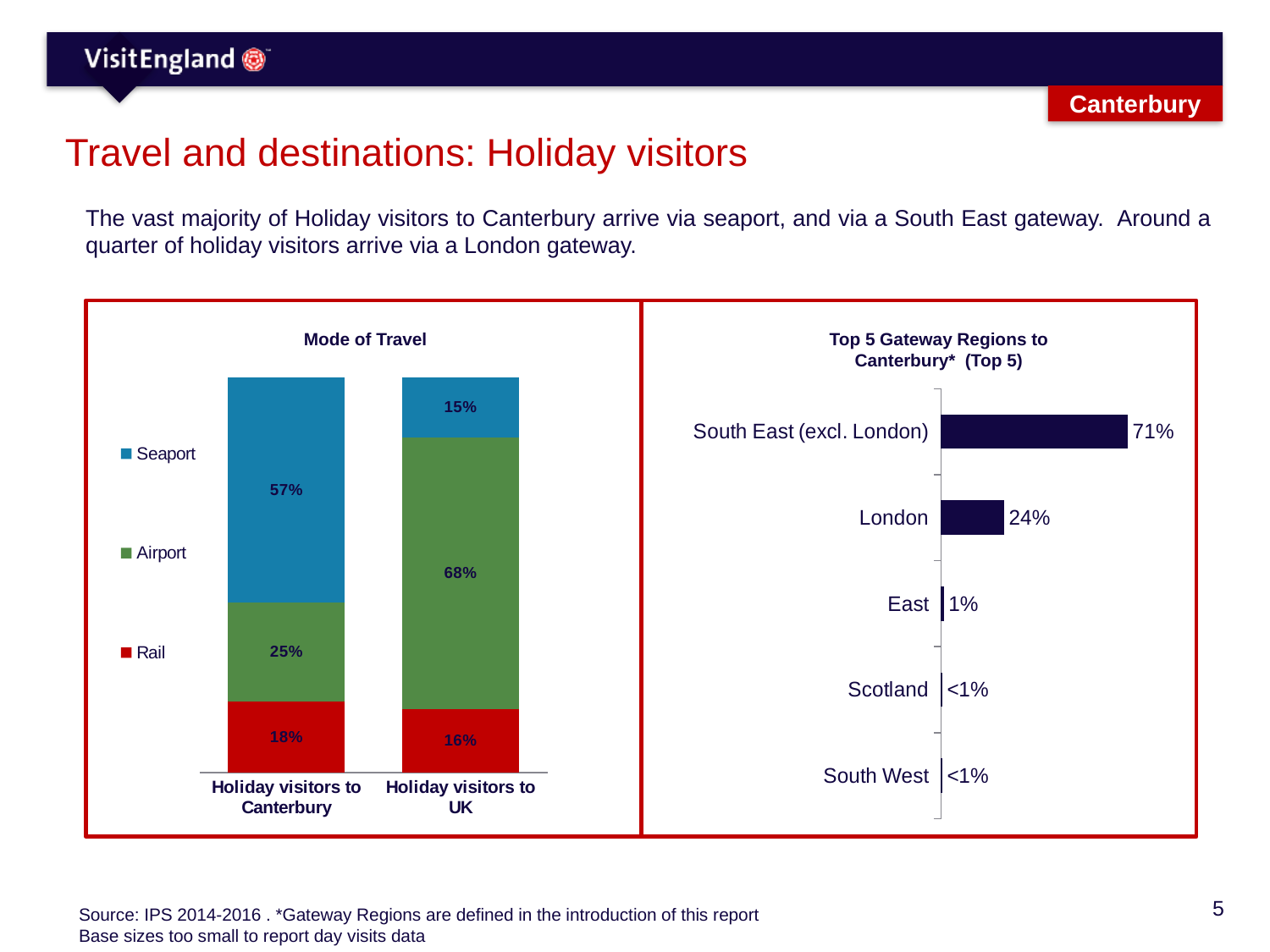
What kind of chart is the Mode of Travel chart? Stacked bar chart In the Top 5 Gateway Regions to Canterbury chart, what is the value for London? 24% In the Mode of Travel chart, is the Airport share larger for Holiday visitors to Canterbury or for Holiday visitors to UK? Holiday visitors to UK How many gateway regions are shown in the Top 5 Gateway Regions to Canterbury chart? 5 In the Mode of Travel chart, which mode of travel has the largest share for Holiday visitors to UK? Airport In the Top 5 Gateway Regions to Canterbury chart, what is the difference between the values for South East (excl. London) and London? 47% In the Mode of Travel chart, what is the Rail share for Holiday visitors to Canterbury? 18% In the Mode of Travel chart, what is the difference between the Seaport share for Holiday visitors to Canterbury and for Holiday visitors to UK? 42% In the Mode of Travel chart, what percentage of Holiday visitors to UK arrive by Airport? 68% In the Top 5 Gateway Regions to Canterbury chart, which gateway region has the highest value? South East (excl. London) How many series does the legend of the Mode of Travel chart list? 3 In the Mode of Travel chart, what percentage of Holiday visitors to Canterbury arrive by Seaport? 57%